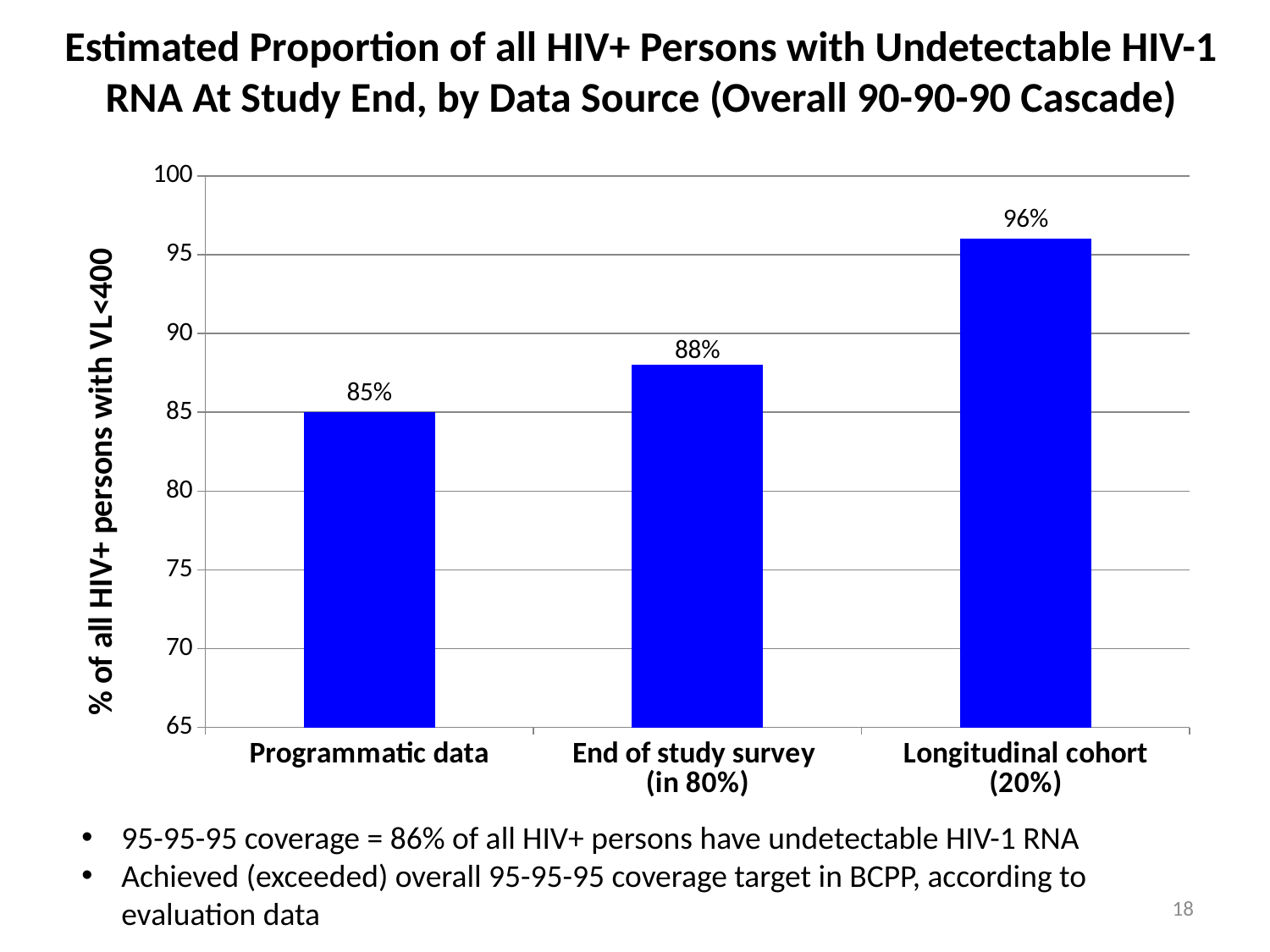
What kind of chart is shown on the slide? bar chart Which data source has the highest proportion of HIV+ persons with VL<400? Longitudinal cohort (20%) What is the value for Longitudinal cohort (20%)? 96% What is the value for Programmatic data? 85% Which data source has the lowest proportion of HIV+ persons with VL<400? Programmatic data What is the difference between the End of study survey (in 80%) value and the Programmatic data value? 3% What is the difference between the Longitudinal cohort (20%) value and the Programmatic data value? 11% Which is larger, the value for End of study survey (in 80%) or the value for Longitudinal cohort (20%)? Longitudinal cohort (20%) What is the label of the vertical axis? % of all HIV+ persons with VL<400 Is the value for Programmatic data greater or less than 90? less How many data sources are shown on the chart? 3 What is the value for End of study survey (in 80%)? 88%